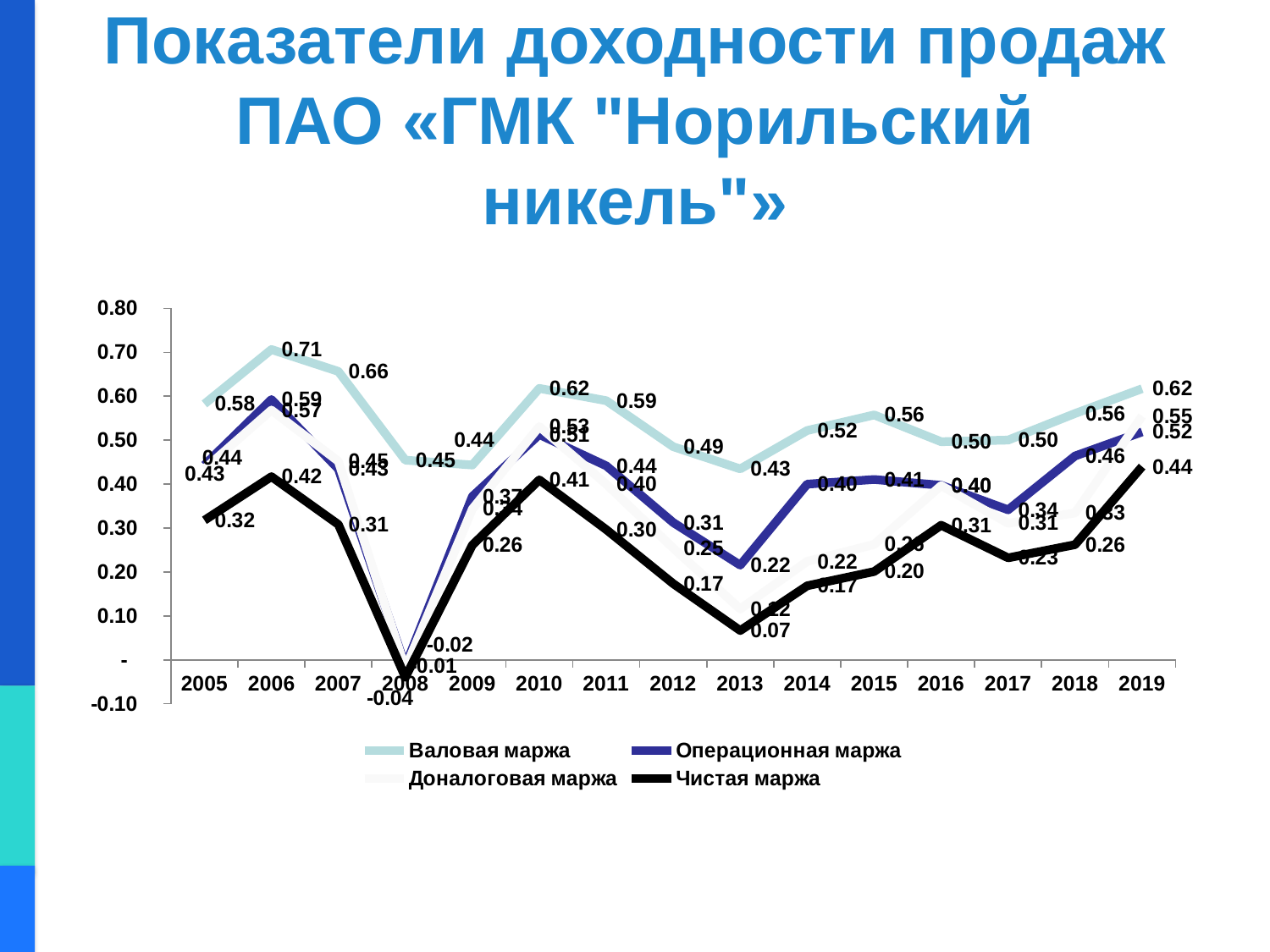
What is the value of Чистая маржа in 2019? 0.44 In which year is Валовая маржа highest? 2006 What is the value of Валовая маржа in 2006? 0.71 How many years are plotted along the x axis? 15 What is the difference between Валовая маржа in 2019 and in 2005? 0.04 What is the value of Чистая маржа in 2013? 0.07 Does Валовая маржа rise or fall from 2016 to 2019? rise What kind of chart is shown on the slide? line chart Which year has the higher Валовая маржа, 2010 or 2011? 2010 How many series does the legend list? 4 Is the value of Валовая маржа in 2013 greater or less than 0.50? less In which year is Чистая маржа lowest? 2008